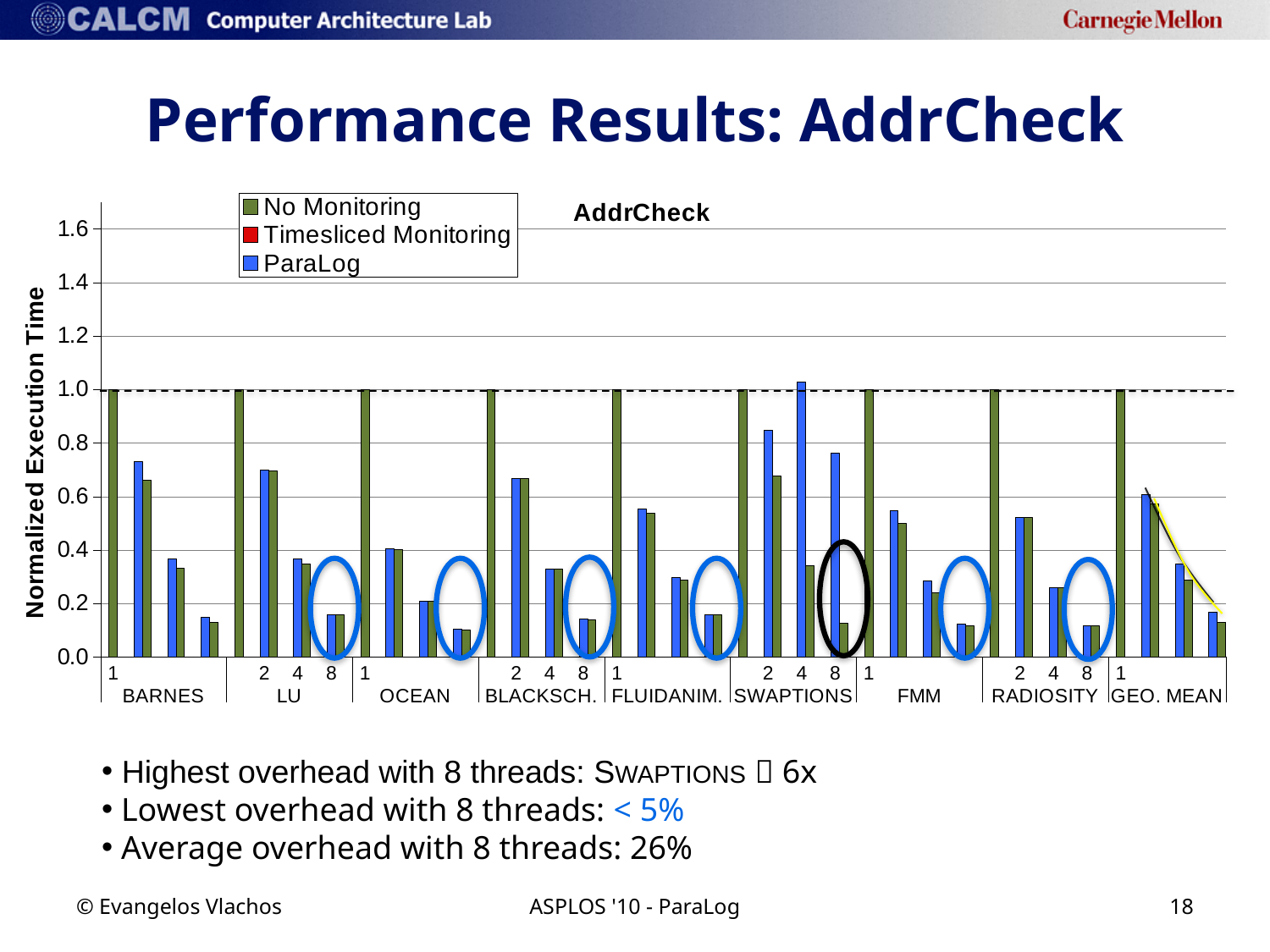
How many series does the chart legend list? 3 Which is larger, the ParaLog value for SWAPTIONS with 2 threads or the ParaLog value for BARNES with 2 threads? SWAPTIONS with 2 threads What is the title of the chart's y axis? Normalized Execution Time Is the ParaLog value for LU with 2 threads greater or less than 0.6? greater Is the ParaLog value for SWAPTIONS with 8 threads greater or less than 0.6? greater What is the title shown inside the chart area? AddrCheck Is the ParaLog value for OCEAN with 8 threads greater or less than 0.2? less What kind of chart is shown on the slide? bar chart What is the No Monitoring value for BARNES with 1 thread? 1.0 Which benchmark has the highest ParaLog value at 8 threads? SWAPTIONS How many benchmark groups are shown along the x axis of the chart? 9